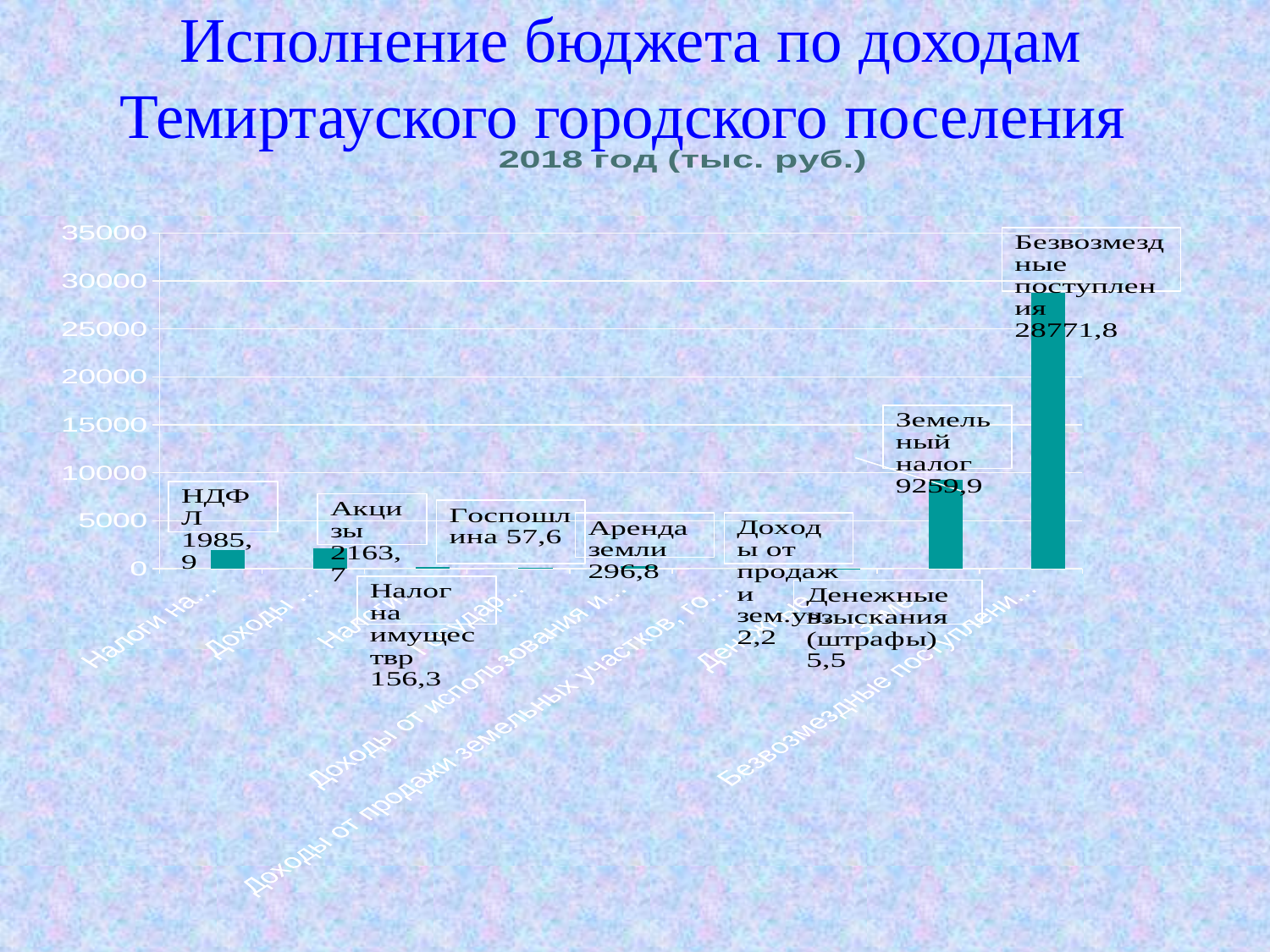
Which is larger, Акцизы or НДФЛ? Акцизы Which category has the highest value? Безвозмездные поступления What is the value for Безвозмездные поступления? 28771,8 What is the value for Акцизы? 2163,7 What type of chart is shown on the slide? bar chart What is the difference between Безвозмездные поступления and Земельный налог? 19511,9 What is the value for НДФЛ? 1985,9 What is the title of the chart? 2018 год (тыс. руб.) What is the value for Госпошлина? 57,6 What is the value for Земельный налог? 9259,9 Is the value for Земельный налог greater or less than 10000? less Which category has the lowest value? Доходы от продажи зем.уч.